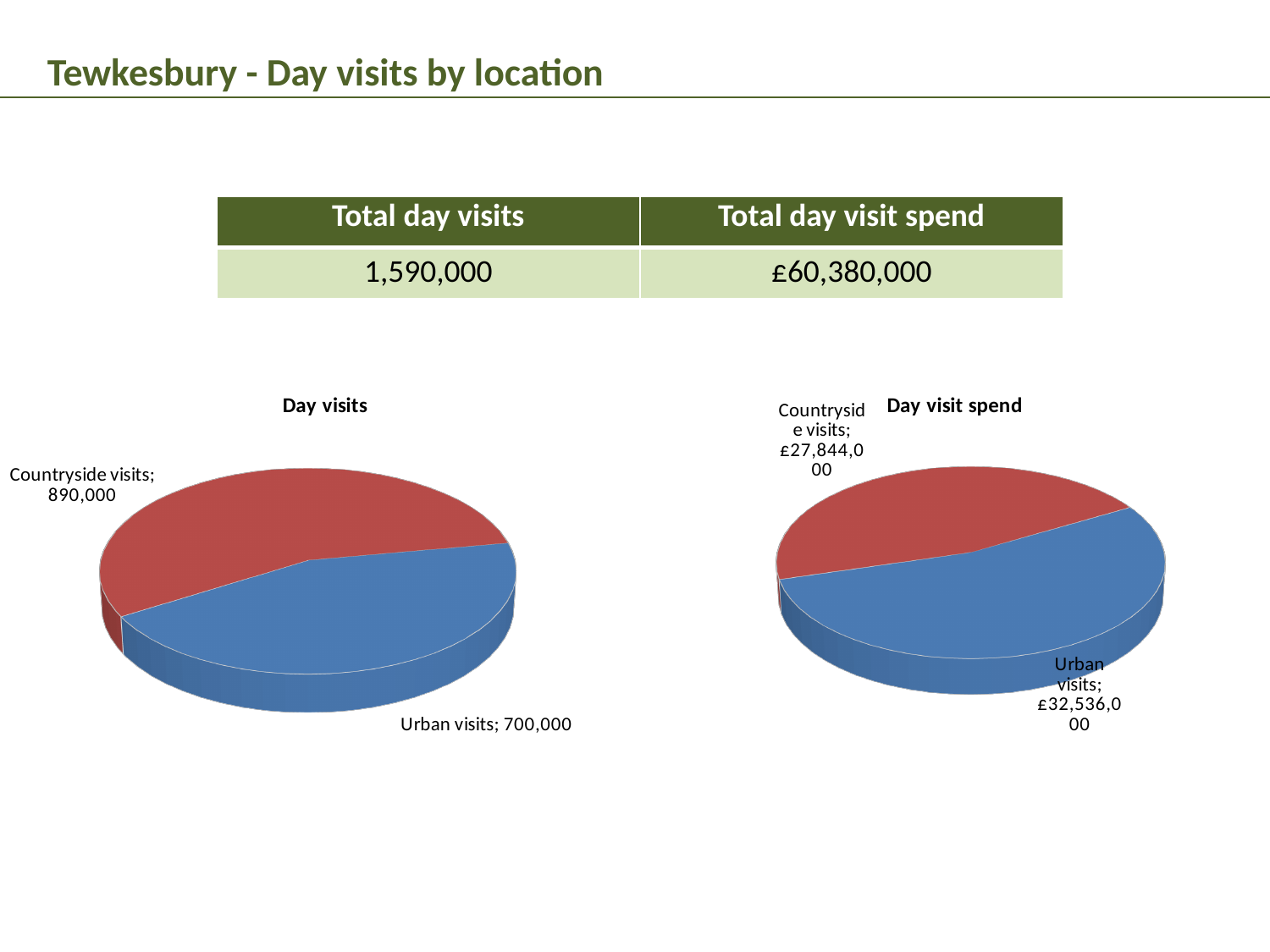
In the Day visit spend chart, what is the spend for countryside visits? £27,844,000 In the Day visits chart, what colour is the Urban visits slice? Blue In the Day visits chart, how many countryside visits are shown? 890,000 In the Day visits chart, what is the difference between countryside visits and urban visits? 190,000 In the Day visits chart, how many urban visits are shown? 700,000 In the Day visit spend chart, is the spend for urban visits larger or smaller than the spend for countryside visits? larger How many slices does the Day visit spend chart have? 2 In the Day visit spend chart, which category has the lower spend? Countryside visits In the Day visit spend chart, what is the spend for urban visits? £32,536,000 In the Day visits chart, which category has the larger number of visits? Countryside visits In the Day visit spend chart, how much more is spent on urban visits than on countryside visits? £4,692,000 What type of chart is the Day visits chart? Pie chart